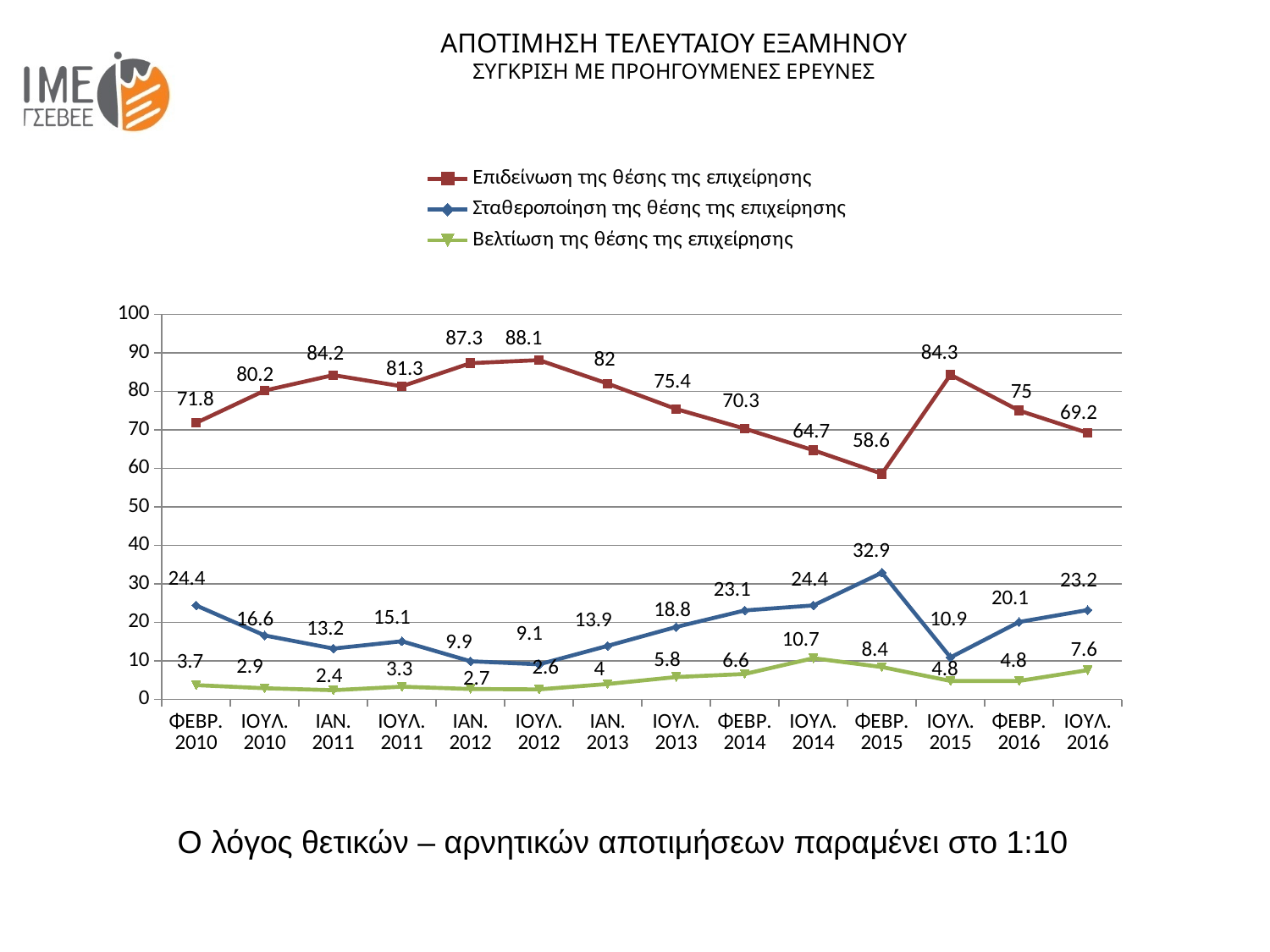
At which time point does Επιδείνωση της θέσης της επιχείρησης reach its highest value? ΙΟΥΛ. 2012 How many time points are plotted along the x axis? 14 What is the difference between Επιδείνωση and Σταθεροποίηση της θέσης της επιχείρησης in ΙΟΥΛ. 2016? 46 By how much did Επιδείνωση της θέσης της επιχείρησης change from ΦΕΒΡ. 2015 to ΙΟΥΛ. 2015? 25.7 At which time point is Βελτίωση της θέσης της επιχείρησης lowest? ΙΑΝ. 2011 Which is larger in ΦΕΒΡ. 2010: Σταθεροποίηση or Βελτίωση της θέσης της επιχείρησης? Σταθεροποίηση της θέσης της επιχείρησης At which time point does Επιδείνωση της θέσης της επιχείρησης reach its lowest value? ΦΕΒΡ. 2015 What is the value of Βελτίωση της θέσης της επιχείρησης for ΙΟΥΛ. 2014? 10.7 What is the value of Επιδείνωση της θέσης της επιχείρησης for ΙΟΥΛ. 2016? 69.2 What is the value of Σταθεροποίηση της θέσης της επιχείρησης for ΦΕΒΡ. 2015? 32.9 How many series does the legend list? 3 What type of chart is shown on the slide? line chart